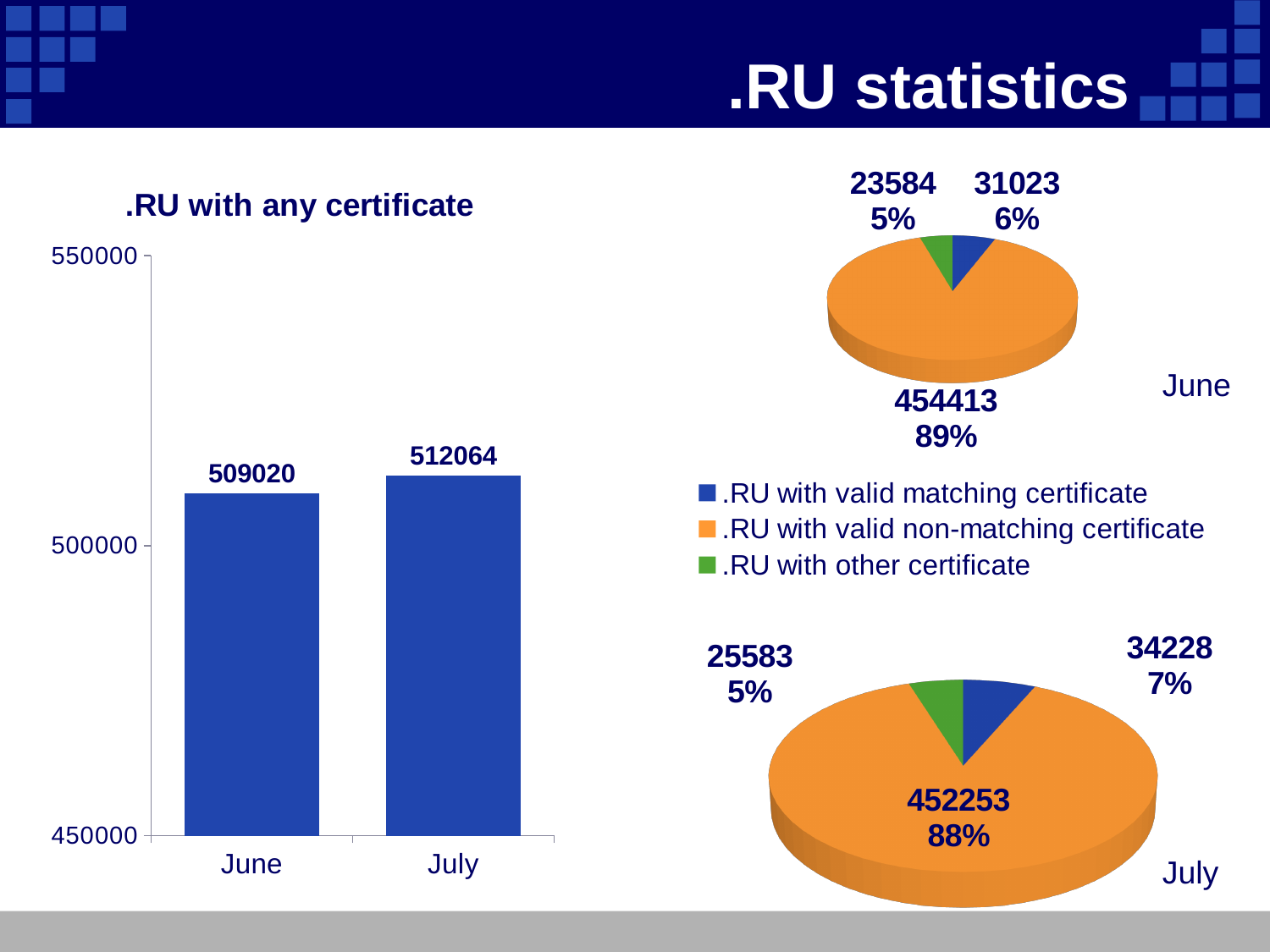
In the June pie chart, what share of the pie is '.RU with valid non-matching certificate'? 89% In the July pie chart, what is the value for '.RU with other certificate'? 25583 In the July pie chart, what share of the pie is '.RU with valid matching certificate'? 7% What kind of chart is the '.RU with any certificate' chart? bar chart In the '.RU with any certificate' bar chart, do the values rise or fall from June to July? rise How many entries does the legend for the pie charts list? 3 In the June pie chart, what is the value for '.RU with valid matching certificate'? 31023 In the July pie chart, which category is the largest? .RU with valid non-matching certificate In the '.RU with any certificate' bar chart, what is the difference between the July and June values? 3044 In the '.RU with any certificate' bar chart, which month has the higher value? July In the '.RU with any certificate' bar chart, what is the value for June? 509020 In the '.RU with any certificate' bar chart, what is the value for July? 512064